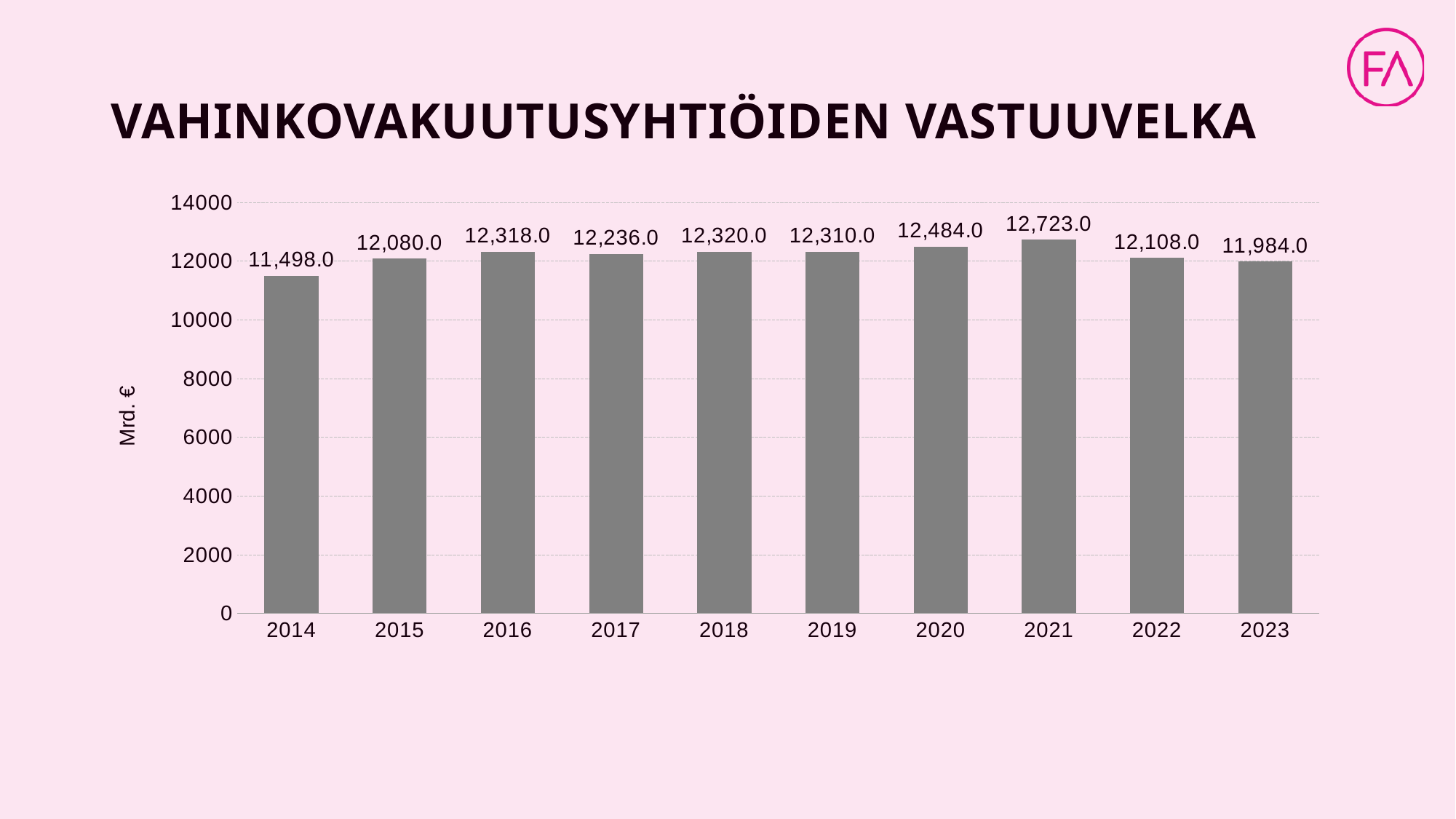
What is the difference between the values for 2022 and 2023? 124.0 What is the difference between the values for 2021 and 2014? 1,225.0 What is the y-axis label of the chart? Mrd. € Which is larger, the value for 2020 or the value for 2017? 2020 Which year has the highest value? 2021 What is the value for 2021? 12,723.0 What is the value for 2023? 11,984.0 Which year has the lowest value? 2014 How many years are shown on the x axis? 10 What is the value for 2014? 11,498.0 What kind of chart is shown on the slide? bar chart Is the value for 2014 greater or less than 12000? less